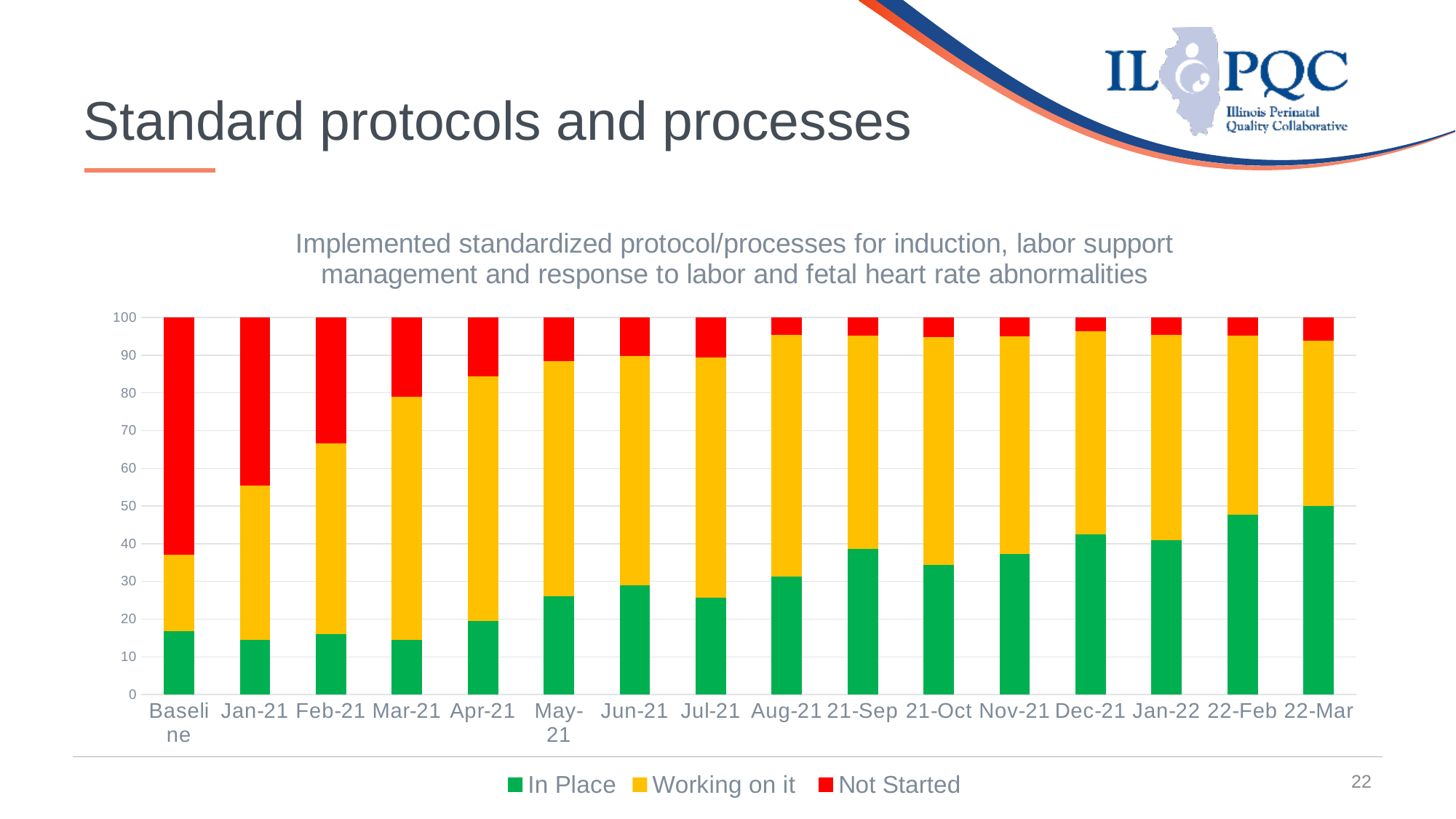
Is the In Place value for Dec-21 greater or less than 40? greater Which category has the largest Not Started segment? Baseline Does the In Place series generally rise or fall from Baseline to 22-Mar? rise Is the Not Started value for Baseline greater or less than 50? greater What is the first category on the x axis? Baseline What kind of chart is shown on the slide? Stacked bar chart Which is larger, the In Place value for Baseline or the In Place value for 22-Feb? 22-Feb How many series does the legend list? 3 Which series is shown in red? Not Started How many categories are shown along the x axis? 16 Is the In Place value for Baseline greater or less than 20? less